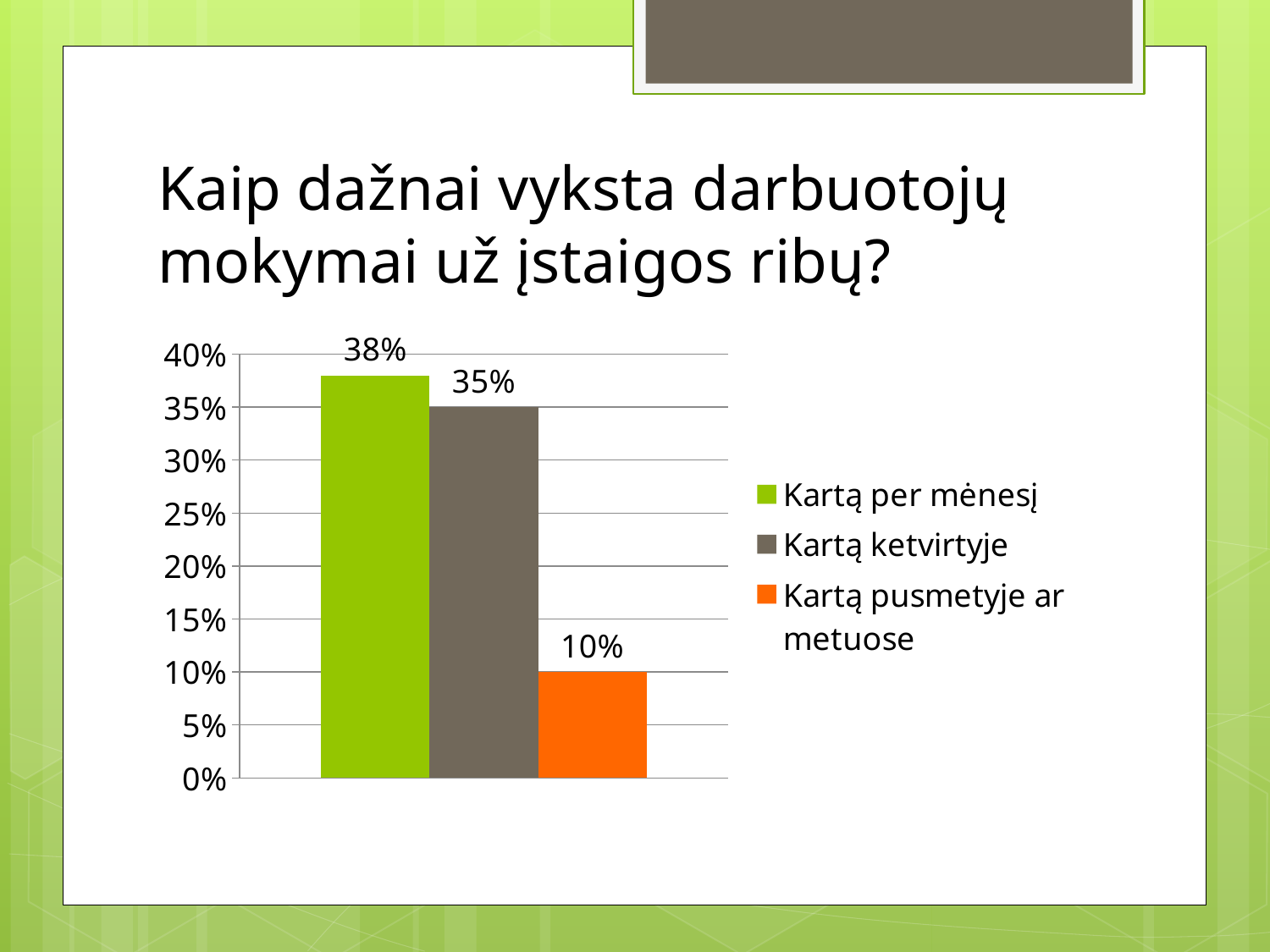
What is the value for "Kartą ketvirtyje"? 35% What is the difference between the values for "Kartą per mėnesį" and "Kartą ketvirtyje"? 3% What kind of chart is shown on the slide? bar chart Which series has the highest value? Kartą per mėnesį Which is larger, the value for "Kartą ketvirtyje" or for "Kartą pusmetyje ar metuose"? Kartą ketvirtyje What is the value for "Kartą per mėnesį"? 38% How many series does the legend list? 3 What is the value for "Kartą pusmetyje ar metuose"? 10% Which series has the lowest value? Kartą pusmetyje ar metuose What is the difference between the values for "Kartą ketvirtyje" and "Kartą pusmetyje ar metuose"? 25% Is the value for "Kartą per mėnesį" greater or less than 30%? greater What colour is the bar for "Kartą pusmetyje ar metuose"? orange